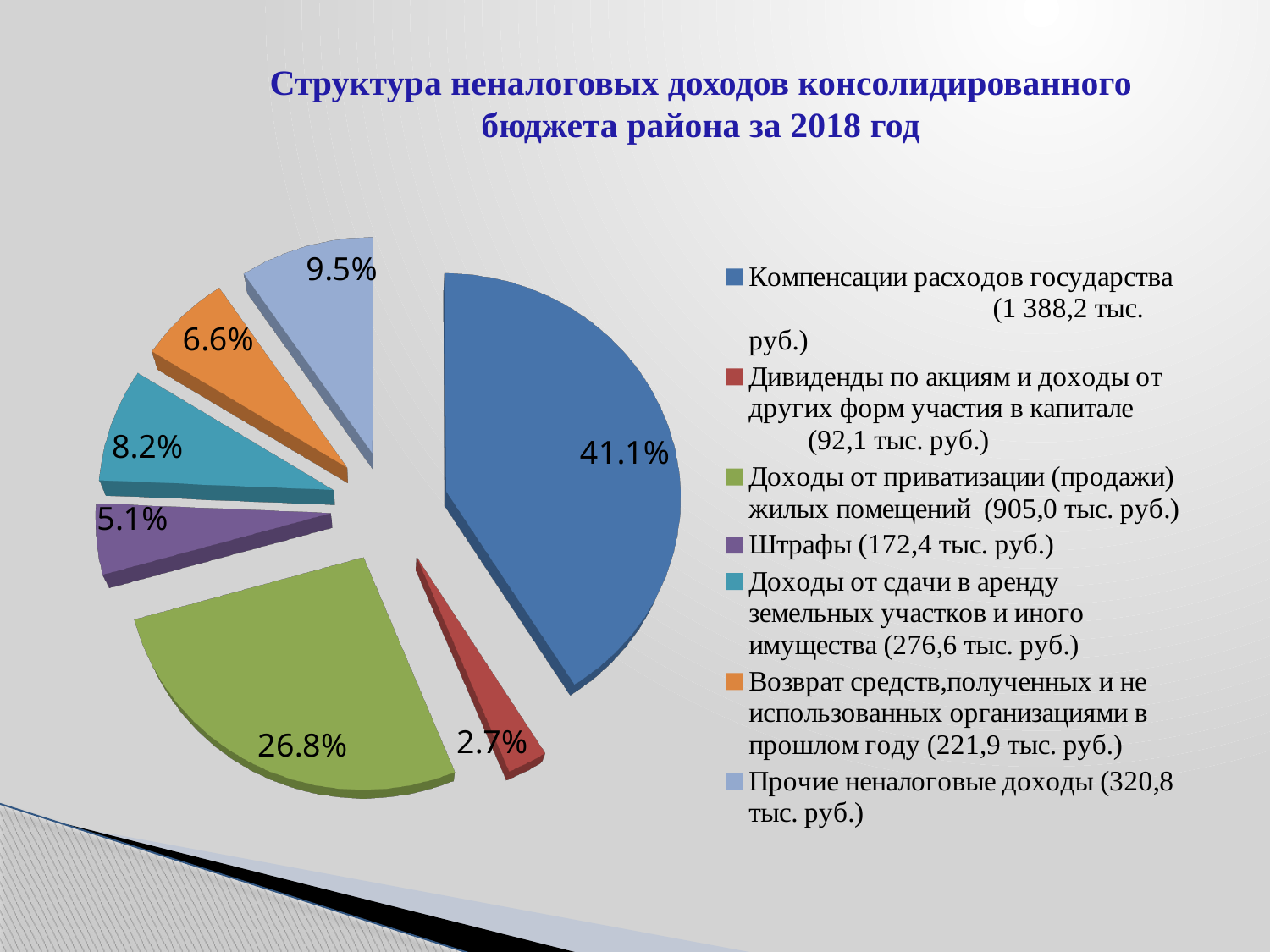
How many entries does the legend list? 7 What amount in тыс. руб. does the legend give for Штрафы? 172,4 тыс. руб. How many slices does the pie chart have? 7 Which category has the smallest share of the pie? Дивиденды по акциям и доходы от других форм участия в капитале What percentage is shown for Прочие неналоговые доходы? 9.5% What kind of chart is shown on the slide? pie chart What percentage is shown for Доходы от приватизации (продажи) жилых помещений? 26.8% What share of the pie is labelled for Компенсации расходов государства? 41.1% What percentage is shown for Штрафы? 5.1% Which has a larger share: Доходы от сдачи в аренду земельных участков и иного имущества or Возврат средств, полученных и не использованных организациями в прошлом году? Доходы от сдачи в аренду земельных участков и иного имущества What is the difference in percentage points between the shares for Компенсации расходов государства and Доходы от приватизации (продажи) жилых помещений? 14.3 Which category has the largest share of the pie? Компенсации расходов государства